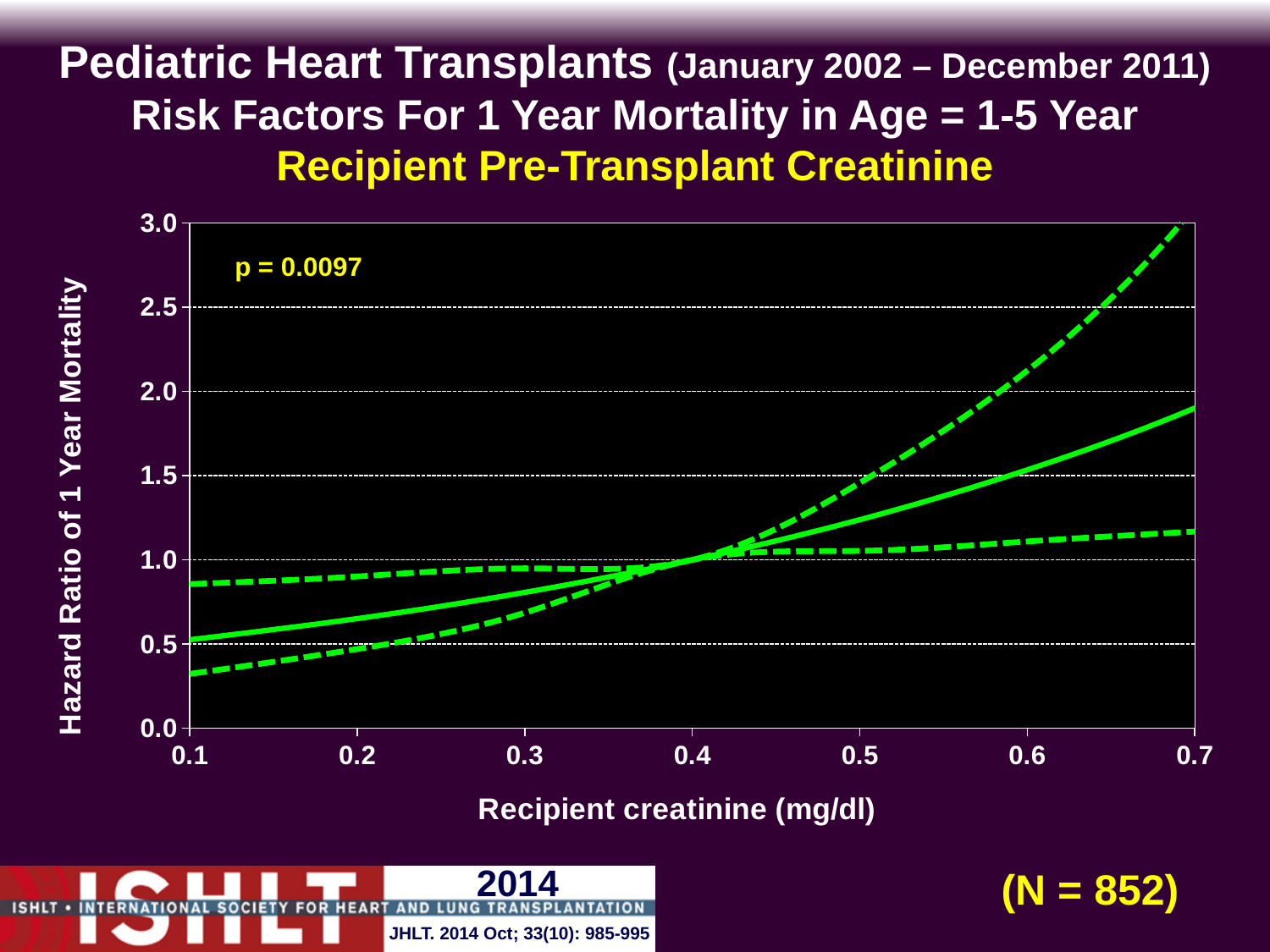
Which line has the highest value at a recipient creatinine of 0.7 mg/dl: the solid line, the upper dashed line, or the lower dashed line? upper dashed line Is the value of the upper dashed line at a recipient creatinine of 0.2 mg/dl greater or less than 1.0? less Is the value of the lower dashed line at a recipient creatinine of 0.1 mg/dl greater or less than 0.5? less Is the value of the solid line at a recipient creatinine of 0.3 mg/dl greater or less than 1.0? less Does the solid hazard ratio line rise or fall as recipient creatinine increases from 0.1 to 0.7 mg/dl? rise What p-value is printed on the chart? p = 0.0097 What sample size (N) is shown on the slide? N = 852 What kind of chart is shown on the slide? line chart How many lines are plotted on the chart? 3